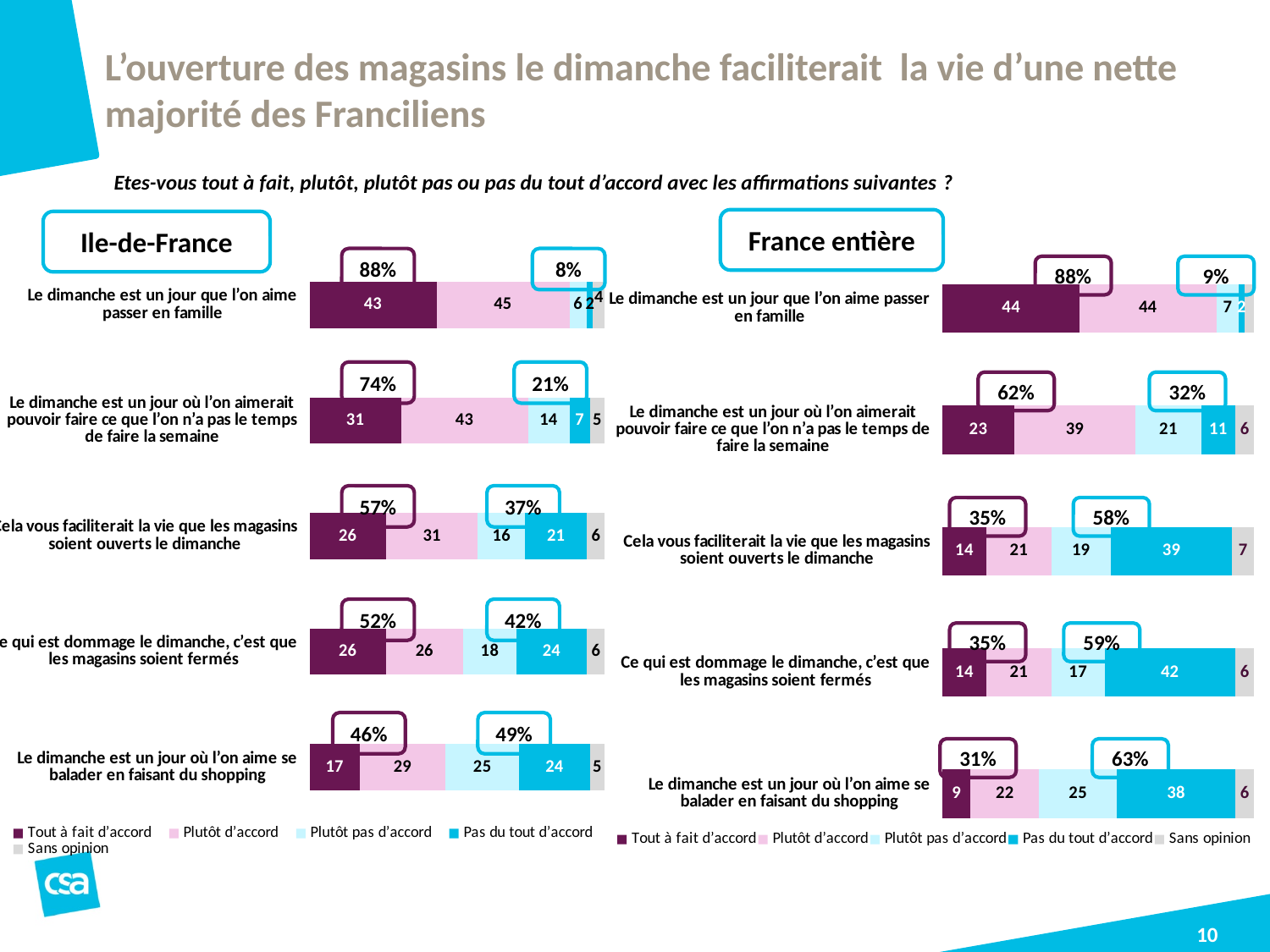
In the France entière chart, which is larger for 'Cela vous faciliterait la vie que les magasins soient ouverts le dimanche': 'Pas du tout d'accord' or 'Plutôt pas d'accord'? Pas du tout d'accord How many statements are shown in the Ile-de-France chart? 5 In the Ile-de-France chart, what is the 'Tout à fait d'accord' value for 'Le dimanche est un jour que l'on aime passer en famille'? 43 In the France entière chart, what is the combined agreement percentage shown above the bar for 'Le dimanche est un jour où l'on aime se balader en faisant du shopping'? 31% In the France entière chart, which statement has the lowest 'Tout à fait d'accord' value? Le dimanche est un jour où l'on aime se balader en faisant du shopping How many series does the legend of the France entière chart list? 5 What type of chart is the Ile-de-France chart? Stacked bar chart In the France entière chart, what is the 'Pas du tout d'accord' value for 'Ce qui est dommage le dimanche, c'est que les magasins soient fermés'? 42 In the Ile-de-France chart, which statement has the highest 'Tout à fait d'accord' value? Le dimanche est un jour que l'on aime passer en famille In the Ile-de-France chart, what is the difference between the 'Plutôt d'accord' and 'Tout à fait d'accord' values for 'Cela vous faciliterait la vie que les magasins soient ouverts le dimanche'? 5 In the France entière chart, what is the 'Plutôt d'accord' value for 'Le dimanche est un jour où l'on aimerait pouvoir faire ce que l'on n'a pas le temps de faire la semaine'? 39 In the Ile-de-France chart, what is the 'Plutôt pas d'accord' value for 'Le dimanche est un jour où l'on aime se balader en faisant du shopping'? 25